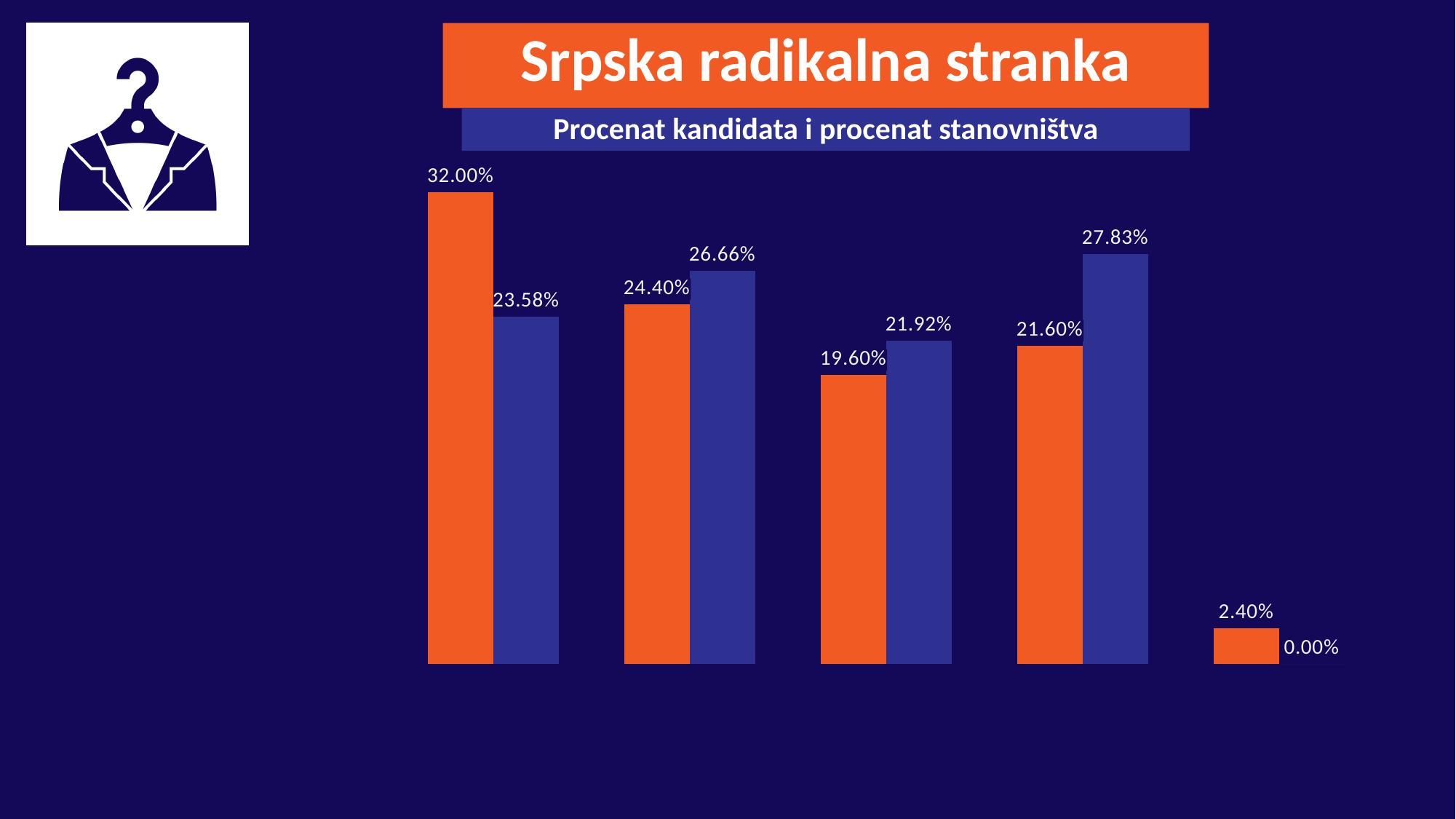
How many groups of bars are plotted in the chart? 5 What is the value of the blue bar in the fourth group from the left? 27.83% What is the difference between the orange and blue bars in the first (leftmost) group? 8.42% What is the subtitle shown above the chart? Procenat kandidata i procenat stanovništva Which orange bar has the highest value? the first (leftmost) group, 32.00% What is the value of the orange bar in the first (leftmost) group? 32.00% What is the value of the orange bar in the third group from the left? 19.60% What is the value of the blue bar in the second group from the left? 26.66% Which blue bar has the lowest value? the rightmost group, 0.00% What type of chart is shown on the slide? bar chart What is the value of the blue bar in the rightmost group? 0.00% In the fourth group from the left, which bar is larger, the orange or the blue one? the blue one